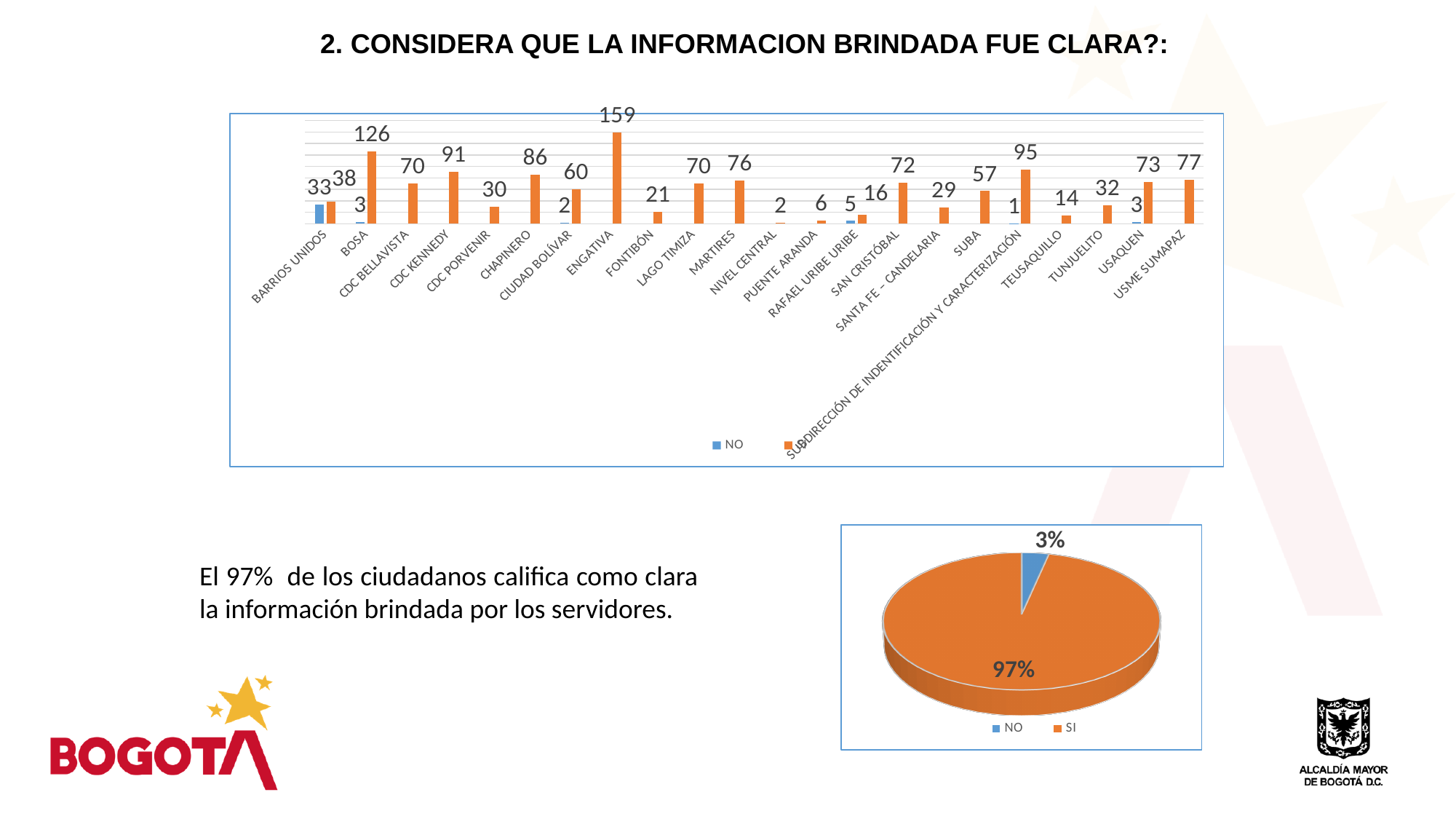
In the bar chart, what is the NO value for BARRIOS UNIDOS? 33 In the pie chart, what share does the SI slice represent? 97% In the bar chart, what is the difference between the SI values for CDC KENNEDY and CHAPINERO? 5 In the bar chart, what is the SI value for ENGATIVA? 159 In the bar chart, which category has the lowest SI value? NIVEL CENTRAL How many series does the legend of the bar chart list? 2 How many categories are shown on the x axis of the bar chart? 22 In the bar chart, which category has the highest SI value? ENGATIVA What kind of chart is the chart at the bottom right of the slide? Pie chart In the pie chart, which colour represents NO? Blue In the bar chart, which has a larger SI value, SUBA or SAN CRISTÓBAL? SAN CRISTÓBAL In the bar chart, what is the SI value for BOSA? 126